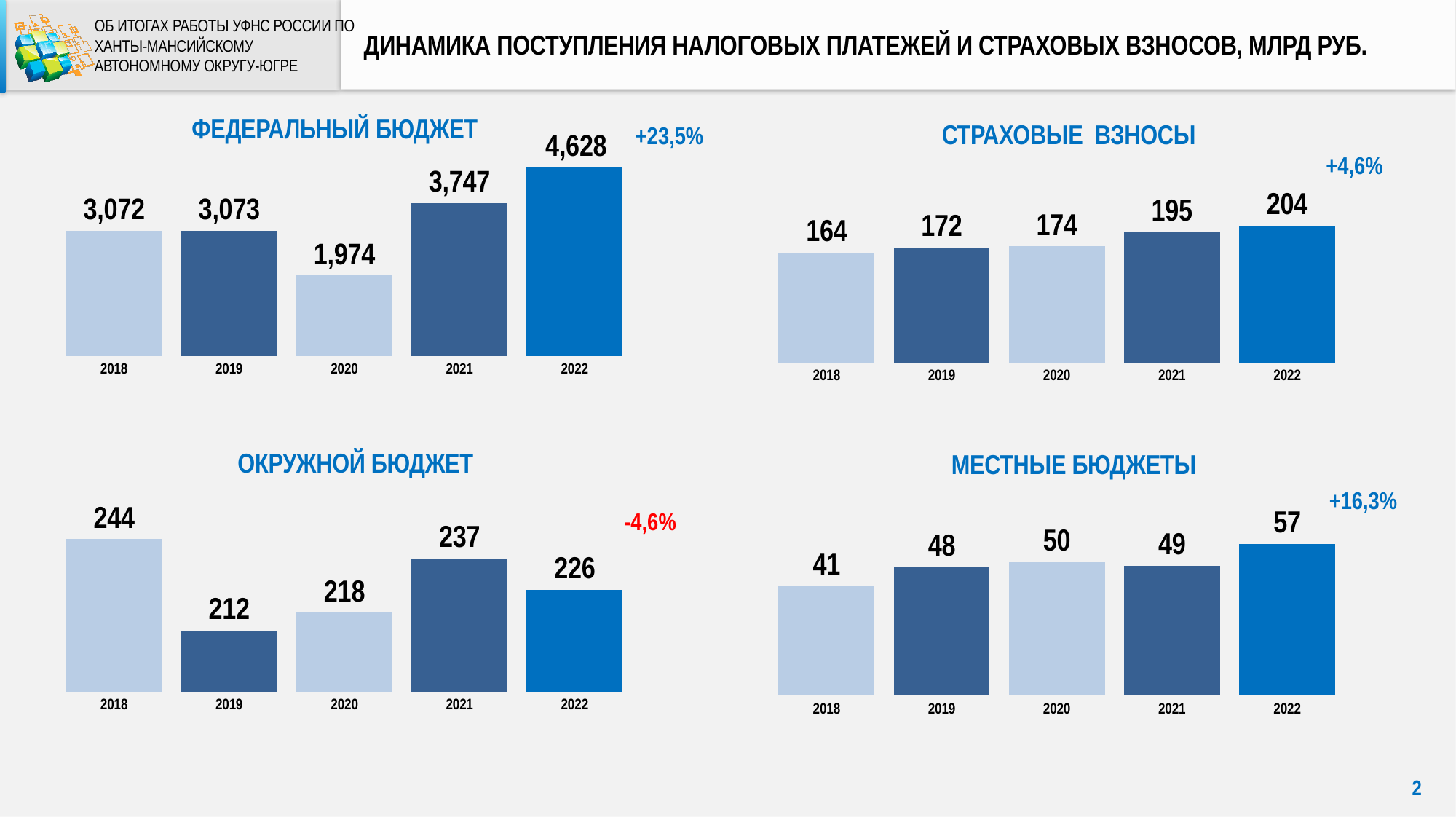
In the МЕСТНЫЕ БЮДЖЕТЫ chart, what is the value for 2018? 41 In the СТРАХОВЫЕ ВЗНОСЫ chart, what is the difference between the 2022 and 2018 values? 40 In the СТРАХОВЫЕ ВЗНОСЫ chart, what is the value for 2021? 195 In the ОКРУЖНОЙ БЮДЖЕТ chart, what is the value for 2022? 226 In the ФЕДЕРАЛЬНЫЙ БЮДЖЕТ chart, which year has the lowest value? 2020 How many bars does the МЕСТНЫЕ БЮДЖЕТЫ chart have? 5 In the ОКРУЖНОЙ БЮДЖЕТ chart, which is larger, the value for 2018 or the value for 2019? 2018 In the МЕСТНЫЕ БЮДЖЕТЫ chart, which year has the highest value? 2022 In the СТРАХОВЫЕ ВЗНОСЫ chart, do the values rise or fall from 2018 to 2022? rise In the ФЕДЕРАЛЬНЫЙ БЮДЖЕТ chart, what is the value for 2020? 1,974 In the ФЕДЕРАЛЬНЫЙ БЮДЖЕТ chart, what is the difference between the 2022 and 2021 values? 881 In the ФЕДЕРАЛЬНЫЙ БЮДЖЕТ chart, which year has the highest value? 2022